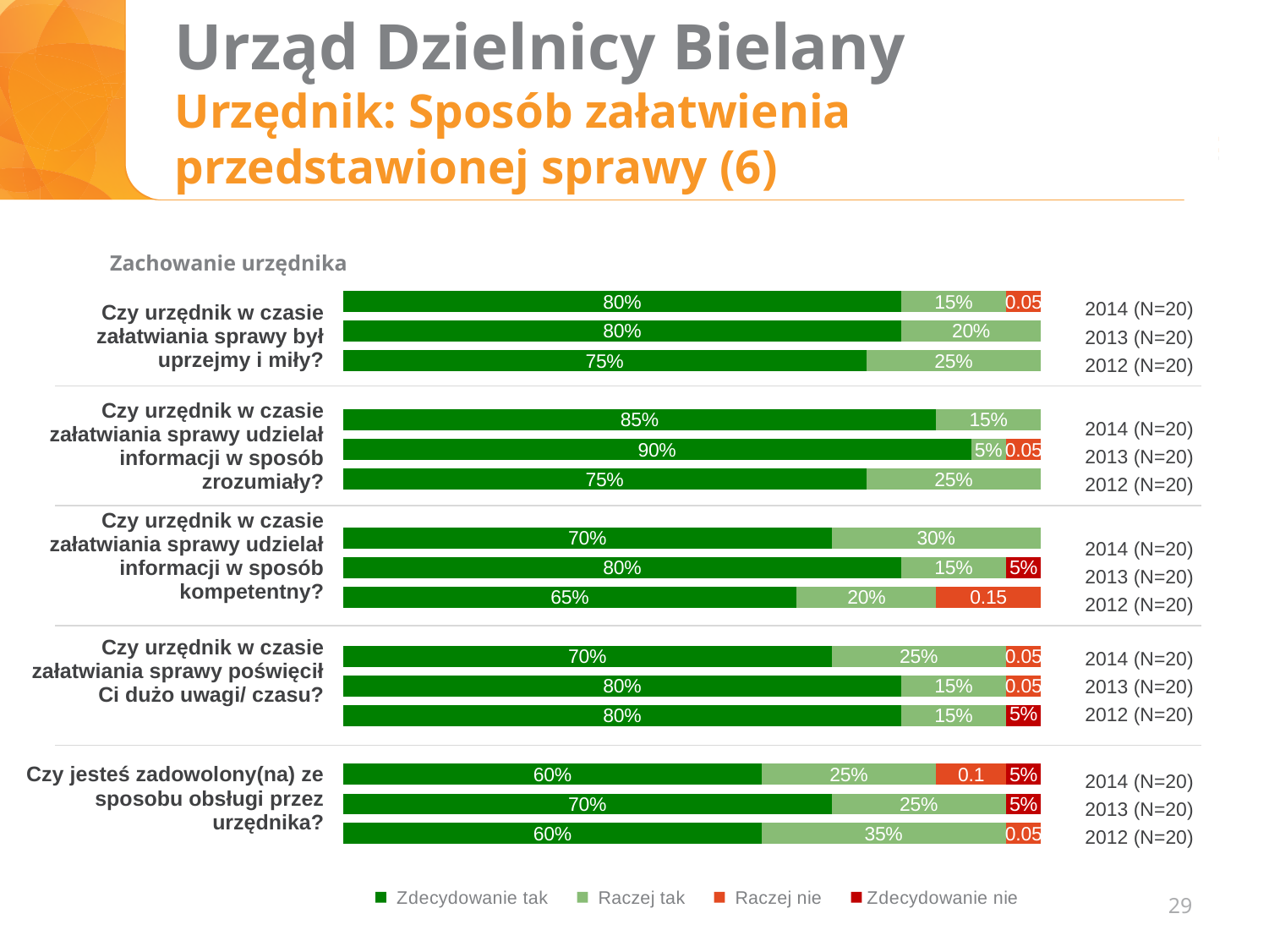
In the 'Czy urzędnik w czasie załatwiania sprawy był uprzejmy i miły?' group, how much larger is the 'Raczej tak' share in 2012 than in 2014? 10 percentage points In the 'Czy jesteś zadowolony(na) ze sposobu obsługi przez urzędnika?' group, what is the 'Raczej tak' value for 2012 (N=20)? 35% In the 'Czy urzędnik w czasie załatwiania sprawy był uprzejmy i miły?' group, what is the 'Zdecydowanie tak' value for 2014 (N=20)? 80% How many series does the legend list? 4 How many years are shown for each question in the chart? 3 In the 'Czy urzędnik w czasie załatwiania sprawy udzielał informacji w sposób zrozumiały?' group, which year has the highest 'Zdecydowanie tak' share? 2013 (N=20) In the 'Czy urzędnik w czasie załatwiania sprawy udzielał informacji w sposób kompetentny?' group, what value is printed for the 'Raczej nie' segment in 2012 (N=20)? 0.15 In the 'Czy urzędnik w czasie załatwiania sprawy udzielał informacji w sposób kompetentny?' group, what is the 'Raczej tak' value for 2014 (N=20)? 30% What kind of chart is shown on the slide? Stacked bar chart In the 'Czy urzędnik w czasie załatwiania sprawy udzielał informacji w sposób kompetentny?' group, which year has the lowest 'Zdecydowanie tak' share? 2012 (N=20) In the 'Czy urzędnik w czasie załatwiania sprawy poświęcił Ci dużo uwagi/ czasu?' group, which year has the larger 'Zdecydowanie tak' share, 2014 or 2013? 2013 (N=20) In the 'Czy urzędnik w czasie załatwiania sprawy udzielał informacji w sposób zrozumiały?' group, what is the 'Zdecydowanie tak' value for 2013 (N=20)? 90%